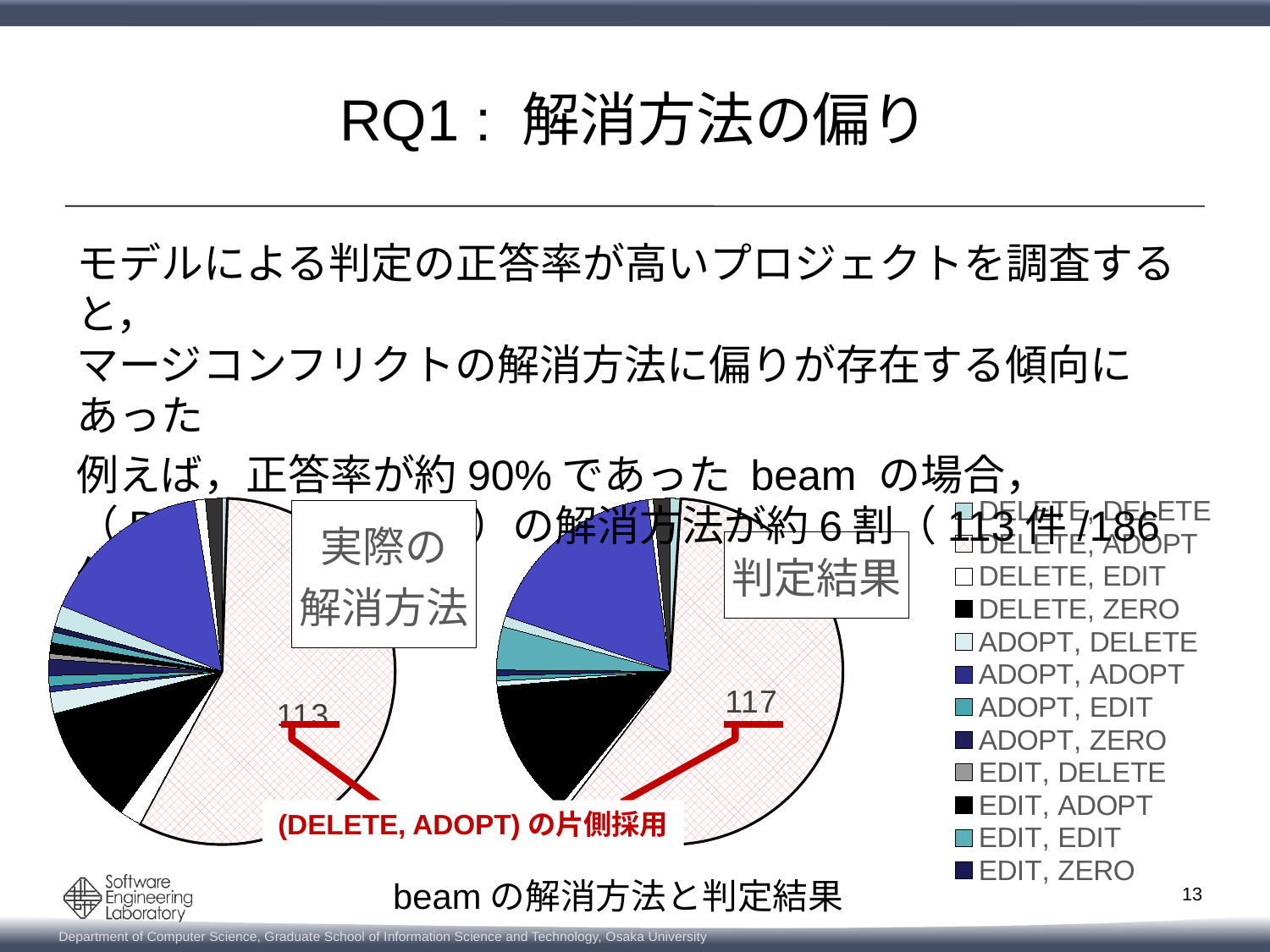
How many pie charts are shown on the slide? 2 Which pie chart shows the larger labelled value for DELETE, ADOPT: 実際の解消方法 or 判定結果? 判定結果 In the left pie chart (実際の解消方法), which slice is larger: DELETE, ADOPT or ADOPT, ADOPT? DELETE, ADOPT In the left pie chart (実際の解消方法), what value is labelled on the DELETE, ADOPT slice? 113 In the left pie chart (実際の解消方法), which category has the largest slice? DELETE, ADOPT In the right pie chart (判定結果), which category has the largest slice? DELETE, ADOPT What is the difference between the DELETE, ADOPT value in the right pie chart (判定結果) and the DELETE, ADOPT value in the left pie chart (実際の解消方法)? 4 In the right pie chart (判定結果), what value is labelled on the DELETE, ADOPT slice? 117 What kind of chart is used on this slide? pie chart How many entries does the legend list? 12 What caption is written below the two pie charts? beam の解消方法と判定結果 What is the title shown on the left pie chart? 実際の解消方法